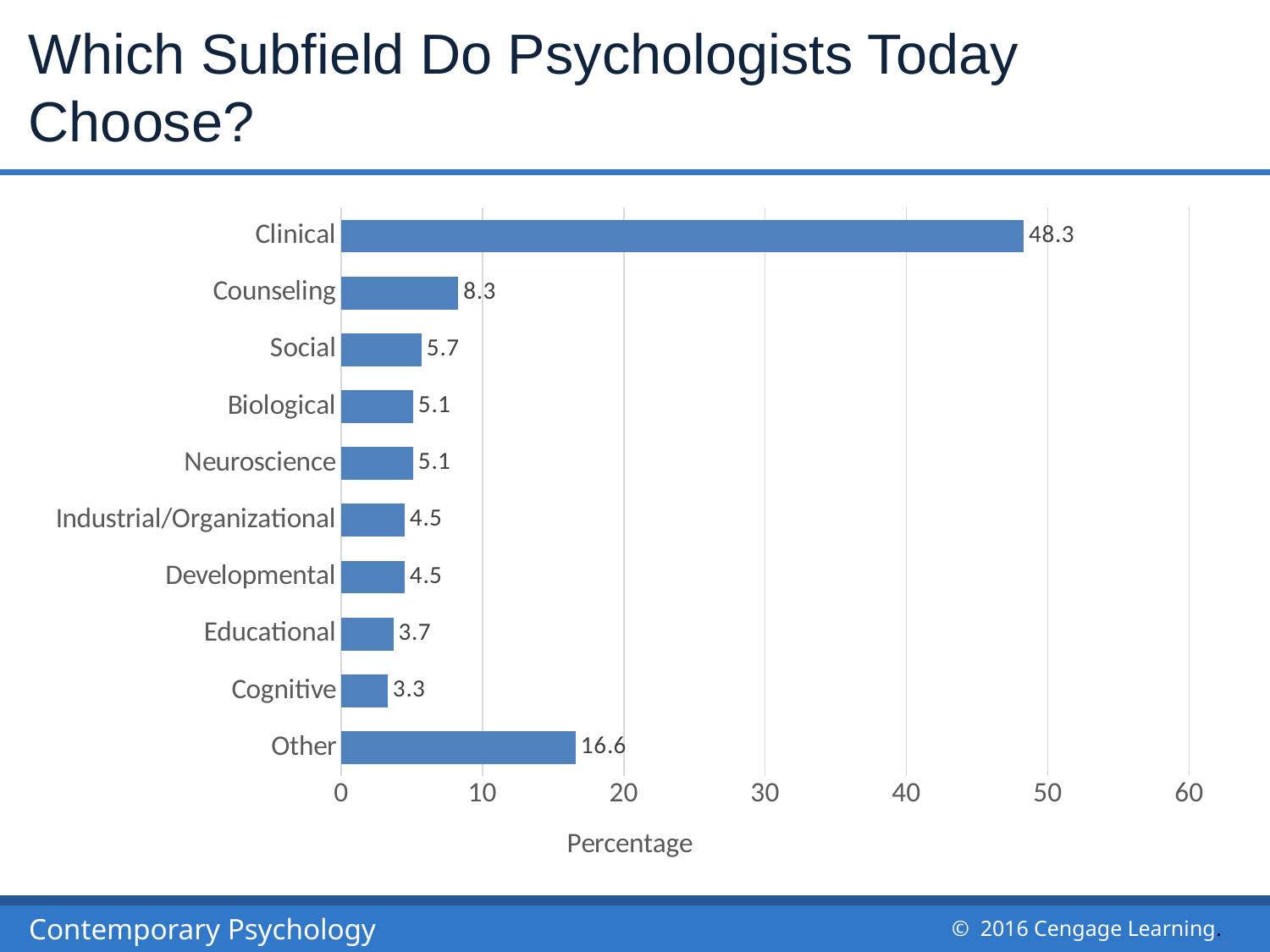
What is the label of the horizontal axis? Percentage Which subfield has the highest percentage? Clinical What is the percentage for Other? 16.6 What is the percentage for Educational? 3.7 How many subfields are shown in the chart? 10 What is the percentage for Clinical? 48.3 What is the percentage for Counseling? 8.3 What is the difference between the percentages for Clinical and Other? 31.7 What is the difference between the percentages for Counseling and Social? 2.6 What kind of chart is shown on the slide? Bar chart Which subfield has the lowest percentage? Cognitive Which has a larger percentage, Other or Counseling? Other